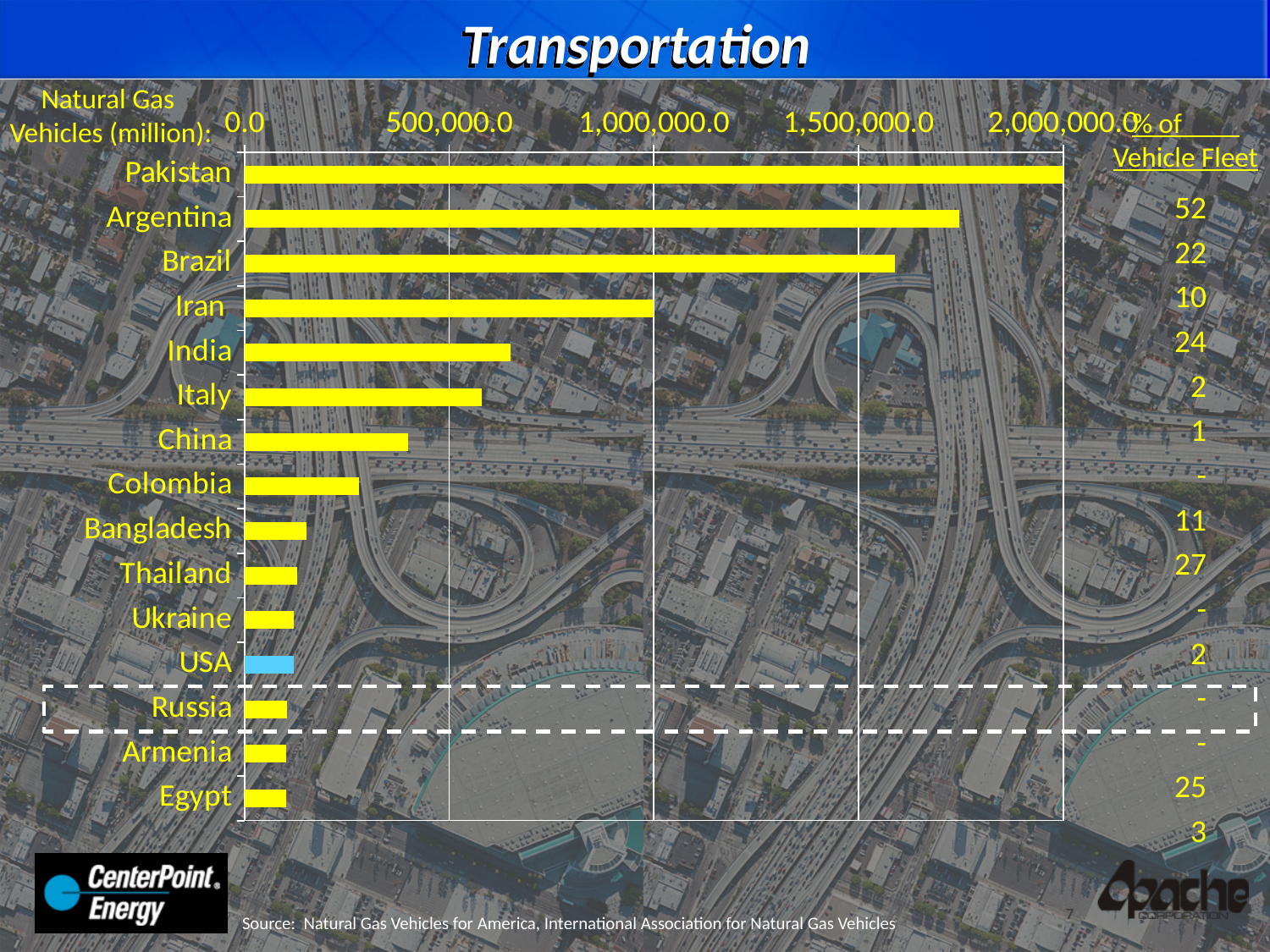
Is the value for China greater or less than 500,000.0? less Which country has the longest bar for natural gas vehicles? Pakistan Which has the larger value, India or Italy? India Is the value for Pakistan greater or less than 1,500,000.0? greater Do the bar lengths increase or decrease going down the chart from Pakistan to Egypt? decrease What kind of chart is shown on the slide? bar chart Is the value for India greater or less than 500,000.0? greater How many countries are listed on the chart? 15 Which country's bar is shown in a different colour (blue) from the others? USA Which has the larger value, Argentina or Brazil? Argentina